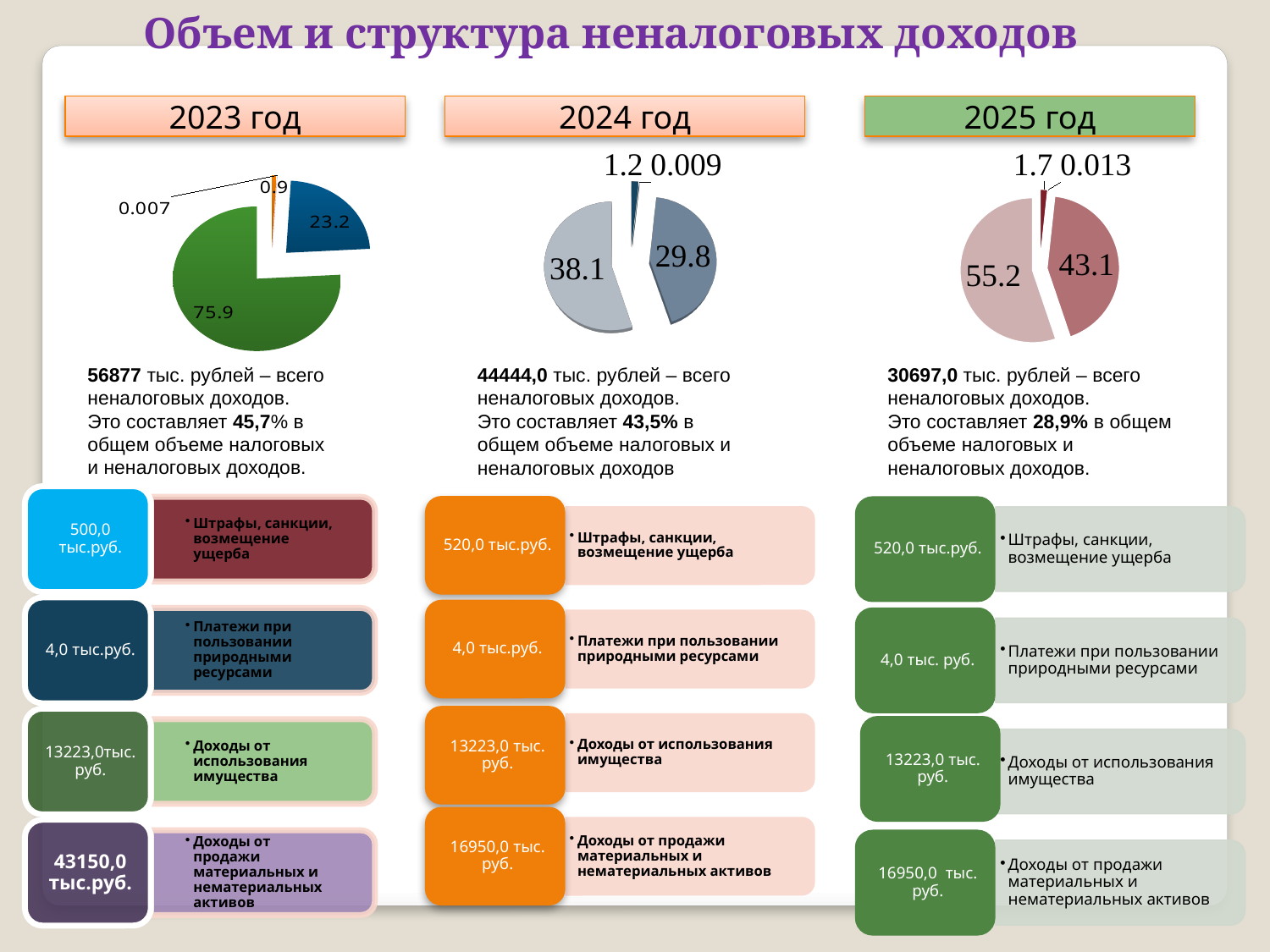
In the 2025 год pie chart, what is the difference between the slices labelled 55.2 and 43.1? 12.1 In the 2023 год pie chart, what is the value of the largest slice? 75.9 In the 2024 год pie chart, what is the difference between the slices labelled 38.1 and 29.8? 8.3 In the 2025 год pie chart, what is the value of the largest slice? 55.2 In the 2023 год pie chart, what is the difference between the two largest slices (75.9 and 23.2)? 52.7 In the 2024 год pie chart, what is the value of the largest slice? 38.1 In the 2024 год pie chart, what is the value of the smallest slice? 0.009 In the 2025 год pie chart, what is the value of the second-largest slice? 43.1 What type of chart is used for the 2023 год data? pie chart In the 2023 год pie chart, what is the value of the smallest slice? 0.007 Which pie chart has the larger biggest slice, 2023 год (75.9) or 2025 год (55.2)? 2023 год How many slices does the 2024 год pie chart have? 4